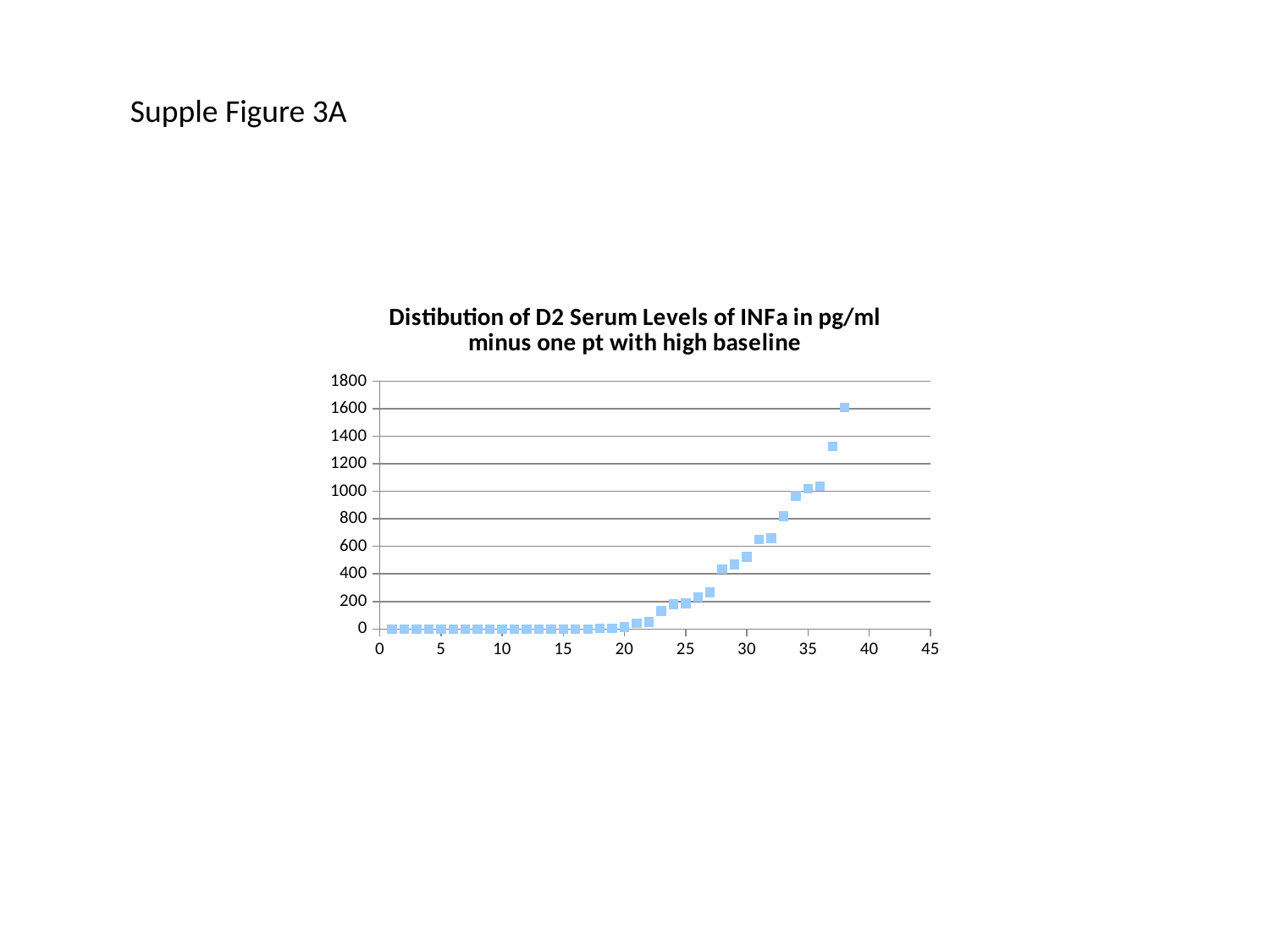
Which point has the larger value, the one at x = 36 or the one at x = 25? x = 36 At which x value is the highest plotted point? 38 What kind of chart is shown on the slide? scatter chart Is the value of the point at x = 33 greater or less than 600? greater Is the value of the point at x = 30 greater or less than 400? greater Is the value of the point at x = 34 greater or less than 1200? less Do the plotted values generally rise or fall as the x value increases? rise What is the highest value shown on the vertical axis? 1800 What is the title of the chart? Distibution of D2 Serum Levels of INFa in pg/ml minus one pt with high baseline